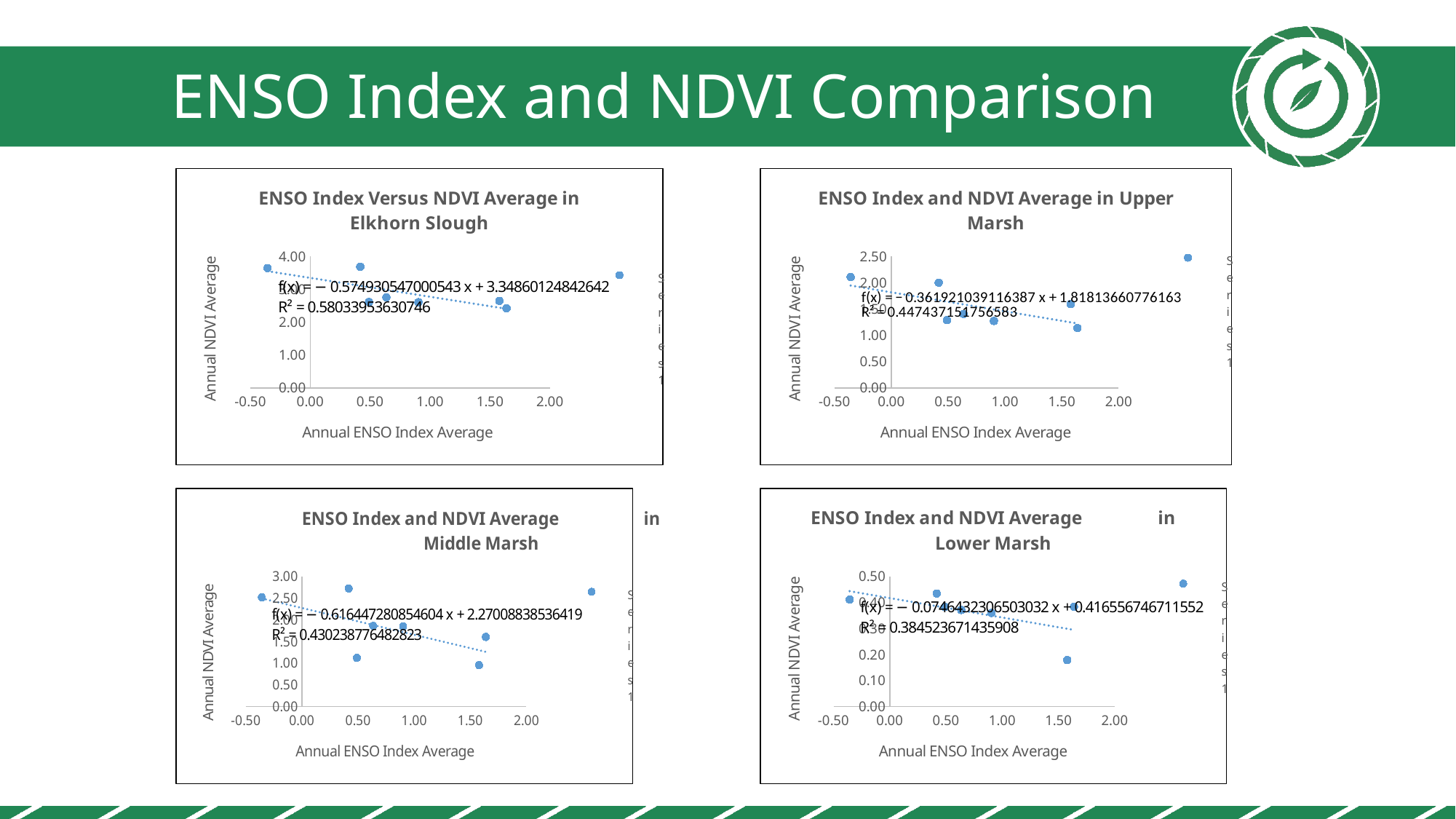
In the 'ENSO Index Versus NDVI Average in Elkhorn Slough' chart, what is the R² value printed on the chart? 0.58033953630746 Which of the four charts shows the highest R² value? ENSO Index Versus NDVI Average in Elkhorn Slough What kind of chart is the top-left chart, 'ENSO Index Versus NDVI Average in Elkhorn Slough'? Scatter chart In the 'ENSO Index and NDVI Average in Lower Marsh' chart, is the lowest plotted Annual NDVI Average greater or less than 0.30? less In the 'ENSO Index and NDVI Average in Middle Marsh' chart, what is the R² value printed on the chart? 0.430238776482823 In the 'ENSO Index Versus NDVI Average in Elkhorn Slough' chart, is the Annual NDVI Average for the point at the lowest ENSO Index (about -0.30) greater or less than 3.00? greater In the 'ENSO Index and NDVI Average in Upper Marsh' chart, what is the R² value printed on the chart? 0.447437151756583 In the 'ENSO Index and NDVI Average in Lower Marsh' chart, what is the R² value printed on the chart? 0.384523671435908 In the 'ENSO Index and NDVI Average in Middle Marsh' chart, does the trendline rise or fall as the Annual ENSO Index Average increases? Fall Which of the four charts shows the lowest R² value? ENSO Index and NDVI Average in Lower Marsh Is the R² value larger in the Elkhorn Slough chart or in the Lower Marsh chart? Elkhorn Slough What is the x-axis title shared by all four charts on the slide? Annual ENSO Index Average